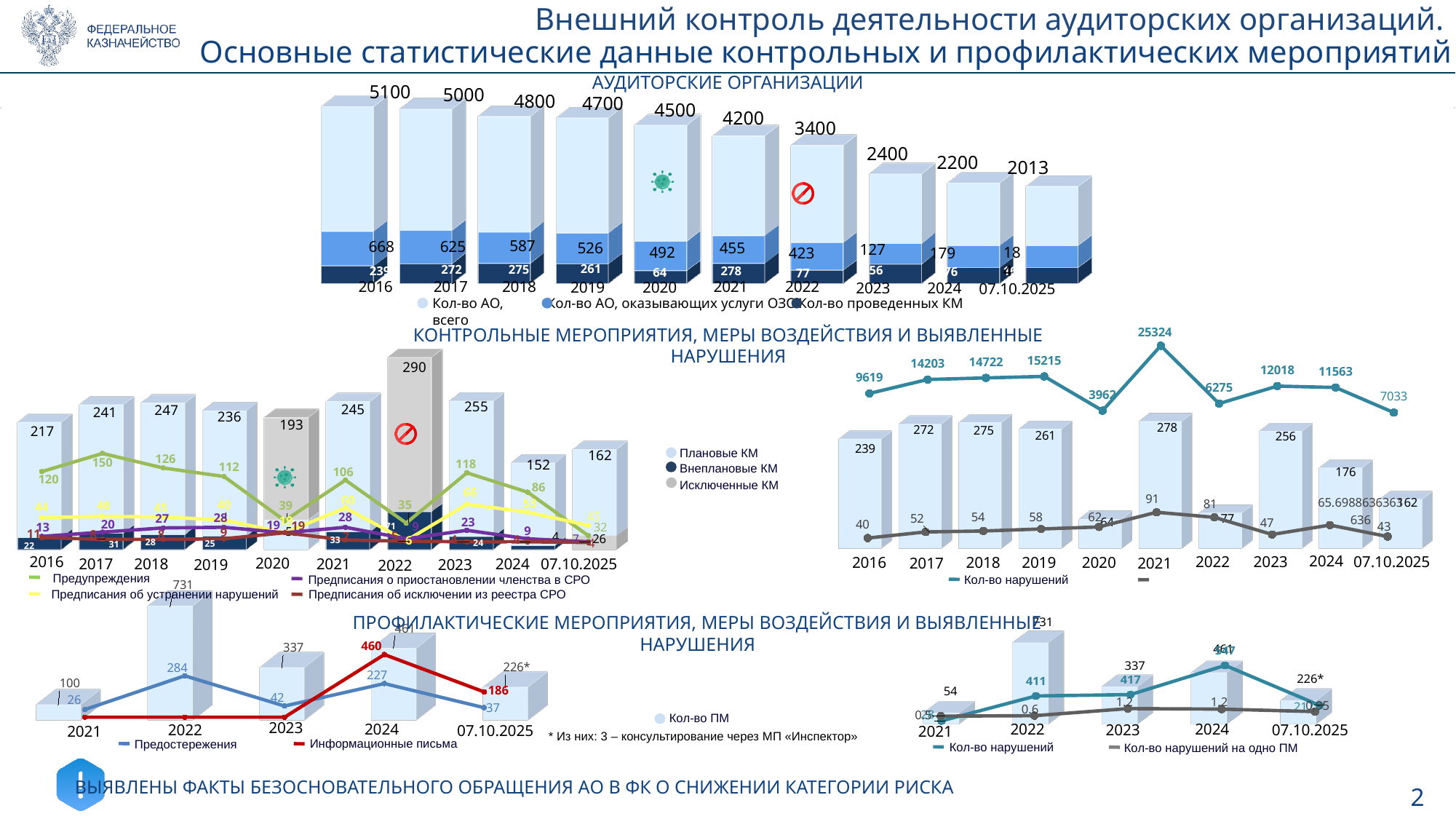
What kind of chart is the top chart 'АУДИТОРСКИЕ ОРГАНИЗАЦИИ'? bar chart In the top chart 'АУДИТОРСКИЕ ОРГАНИЗАЦИИ', what is the value of 'Кол-во АО, всего' for 2016? 5100 In the top chart 'АУДИТОРСКИЕ ОРГАНИЗАЦИИ', what is the difference between 'Кол-во АО, всего' in 2016 and 2017? 100 In the top chart 'АУДИТОРСКИЕ ОРГАНИЗАЦИИ', what is the value of 'Кол-во АО, оказывающих услуги ОЗО' for 2020? 492 In the top chart 'АУДИТОРСКИЕ ОРГАНИЗАЦИИ', which year has the lowest value of 'Кол-во АО, всего'? 07.10.2025 In the middle-left chart 'КОНТРОЛЬНЫЕ МЕРОПРИЯТИЯ, МЕРЫ ВОЗДЕЙСТВИЯ И ВЫЯВЛЕННЫЕ НАРУШЕНИЯ', what is the value of 'Предупреждения' for 2017? 150 In the middle-right chart, in which year is 'Кол-во нарушений' highest? 2021 How many series does the legend of the top chart 'АУДИТОРСКИЕ ОРГАНИЗАЦИИ' list? 3 In the top chart 'АУДИТОРСКИЕ ОРГАНИЗАЦИИ', what is the value of 'Кол-во АО, всего' for 2022? 3400 In the middle-left chart 'КОНТРОЛЬНЫЕ МЕРОПРИЯТИЯ, МЕРЫ ВОЗДЕЙСТВИЯ И ВЫЯВЛЕННЫЕ НАРУШЕНИЯ', which year has the tallest bar? 2022 In the top chart 'АУДИТОРСКИЕ ОРГАНИЗАЦИИ', does 'Кол-во АО, всего' rise or fall from 2016 to 07.10.2025? fall In the bottom-left chart 'ПРОФИЛАКТИЧЕСКИЕ МЕРОПРИЯТИЯ', what is the value of 'Предостережения' for 2022? 284